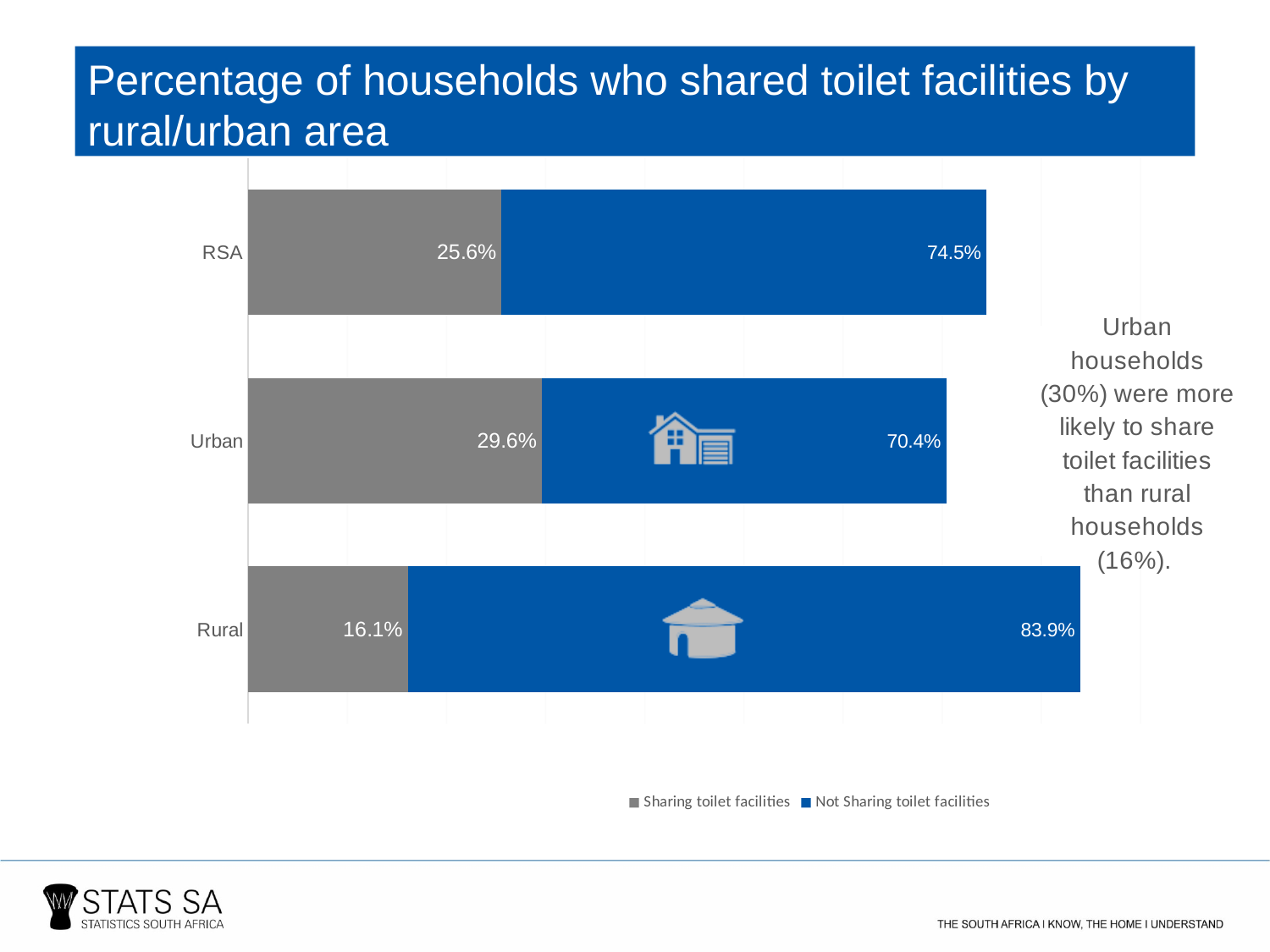
How many areas (categories) are shown in the chart? 3 What percentage of Rural households were not sharing toilet facilities? 83.9% Which is larger: the percentage of RSA households not sharing toilet facilities or the percentage of Rural households not sharing toilet facilities? Rural What percentage of RSA households shared toilet facilities? 25.6% What type of chart is shown on the slide? Stacked bar chart How many series does the legend list? 2 Which area has the lowest percentage of households sharing toilet facilities? Rural What is the difference in percentage points between Urban and Rural households sharing toilet facilities? 13.5 What percentage of Urban households were not sharing toilet facilities? 70.4% What percentage of Rural households shared toilet facilities? 16.1% Which area has the highest percentage of households sharing toilet facilities? Urban What colour represents 'Sharing toilet facilities' in the chart? Grey